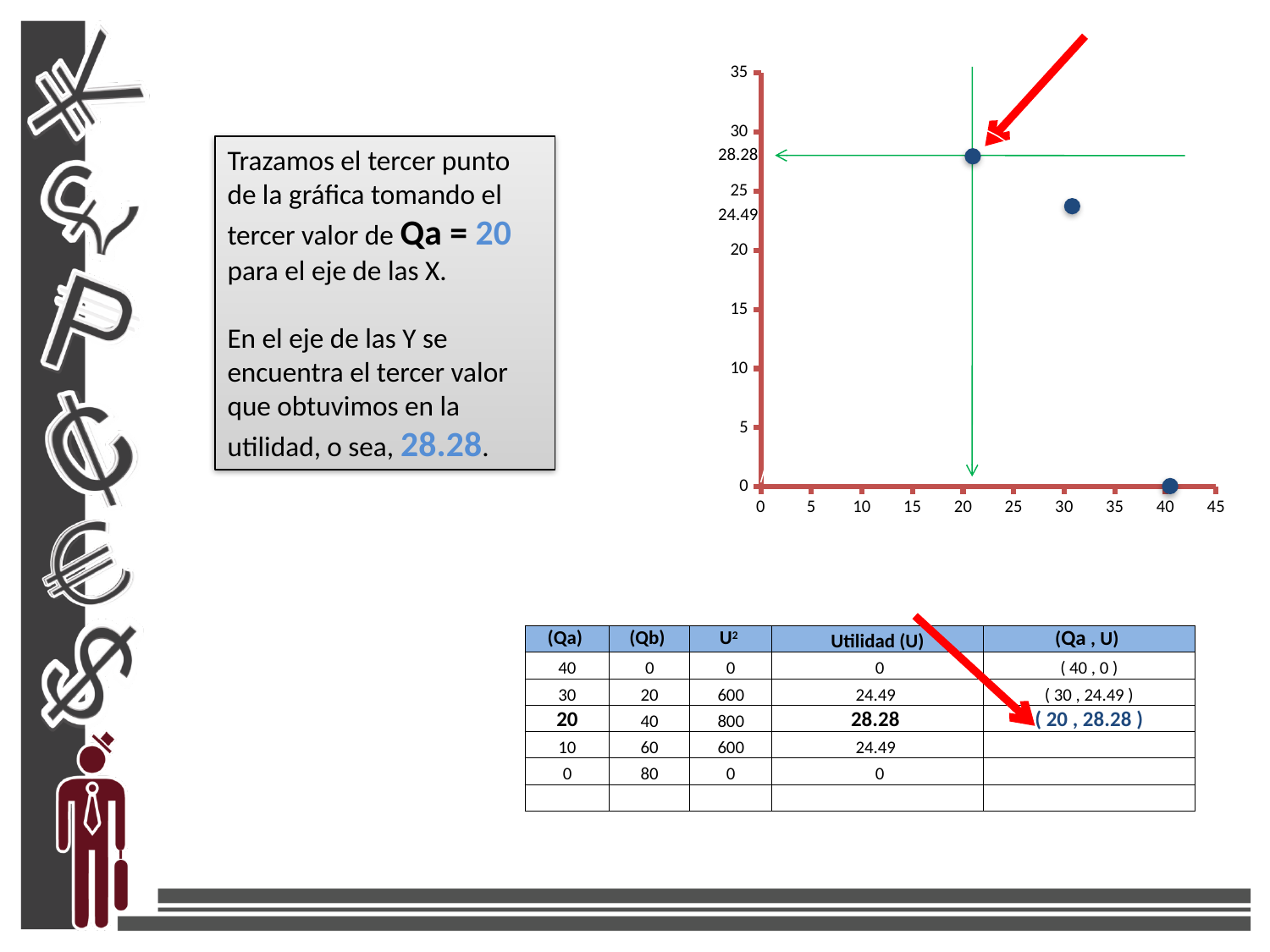
What kind of chart is shown on the slide? scatter chart At which x value is the highest plotted point? 20 What is the y value of the point plotted at x = 30? 24.49 What is the difference between the y values of the points at x = 20 and x = 30? 3.79 How many data points are plotted on the chart? 3 What is the highest tick value shown on the x axis? 45 Which point has the larger y value, the one at x = 20 or the one at x = 30? x = 20 At which x value is the lowest plotted point? 40 Do the plotted y values rise or fall as x increases from 20 to 40? fall Is the y value of the point at x = 30 greater or less than 20? greater What is the y value of the point plotted at x = 20? 28.28 What is the y value of the point plotted at x = 40? 0